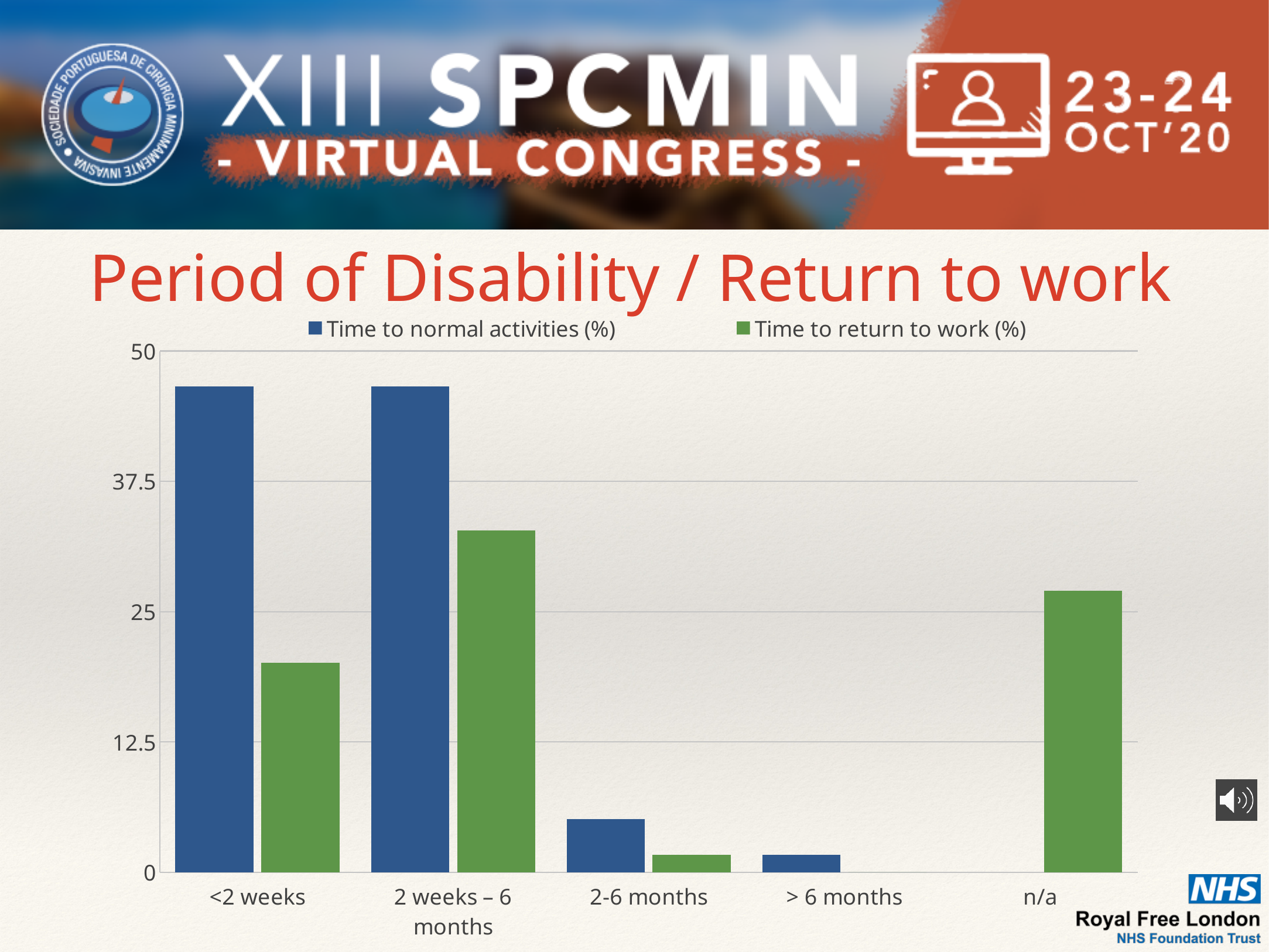
Is the value for Time to normal activities (%) at 2-6 months greater or less than 12.5? less Which category has the highest value for Time to return to work (%)? 2 weeks – 6 months How many series does the legend list? 2 Is the value for Time to return to work (%) at n/a greater or less than 25? greater What colour represents the Time to return to work (%) series? green Is the value for Time to normal activities (%) at <2 weeks greater or less than 37.5? greater For Time to return to work (%), which is larger: the value at n/a or the value at 2 weeks – 6 months? 2 weeks – 6 months How many categories are shown on the x axis? 5 At <2 weeks, which series has the larger value: Time to normal activities (%) or Time to return to work (%)? Time to normal activities (%) What kind of chart is shown on the slide? bar chart